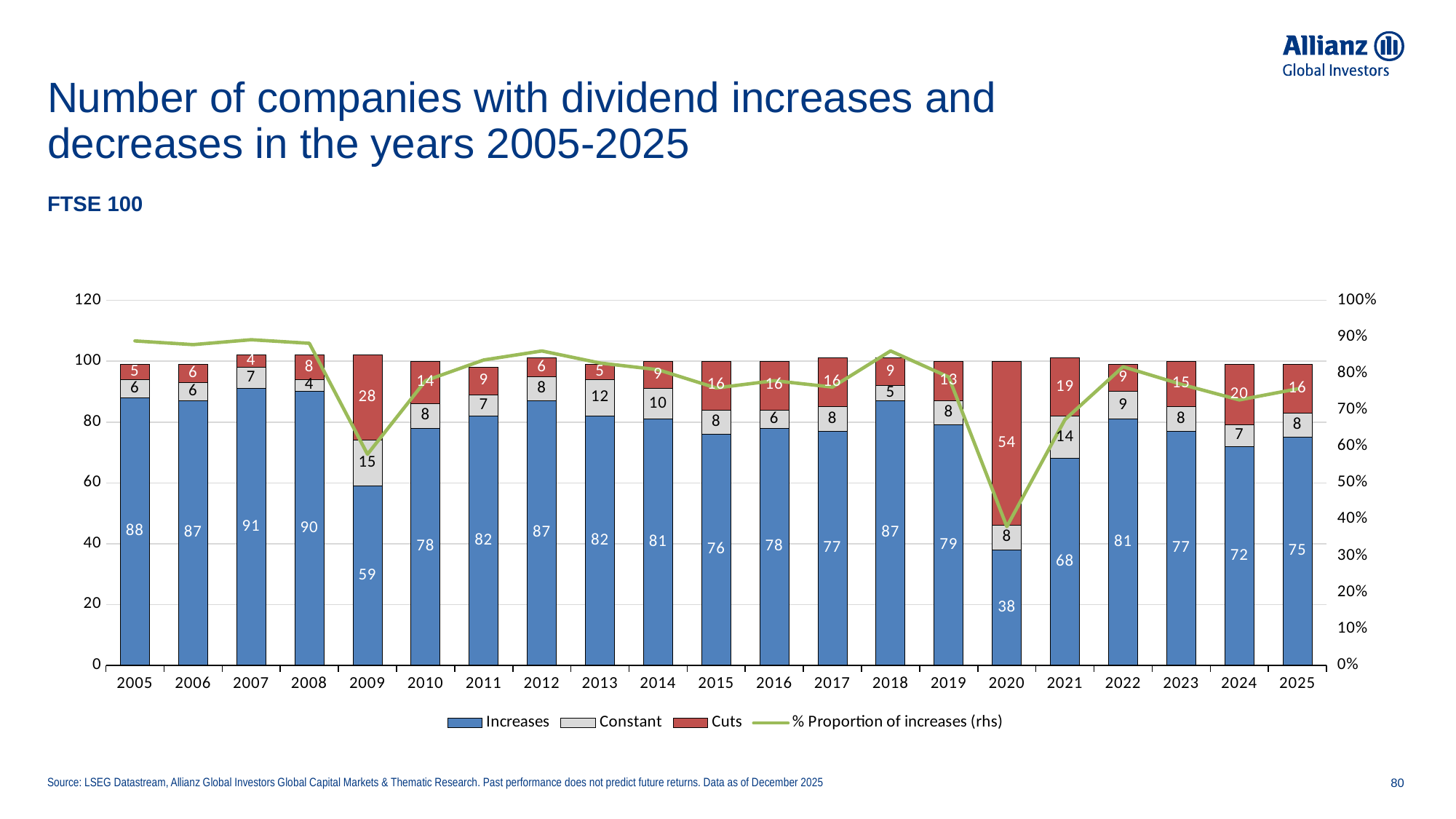
How many years are shown on the x axis? 21 Is the % Proportion of increases line value for 2020 greater or less than 50%? less What is the value for Constant in 2021? 14 What is the value for Cuts in 2009? 28 What is the difference between the Increases value in 2007 and in 2020? 53 Which year has the larger Cuts value, 2023 or 2024? 2024 What is the total of the stacked bar for 2009? 102 In which year is the Cuts value highest? 2020 How many companies had dividend increases in 2020? 38 In which year is the Increases value highest? 2007 In which year is the Increases value lowest? 2020 How many series does the legend list? 4